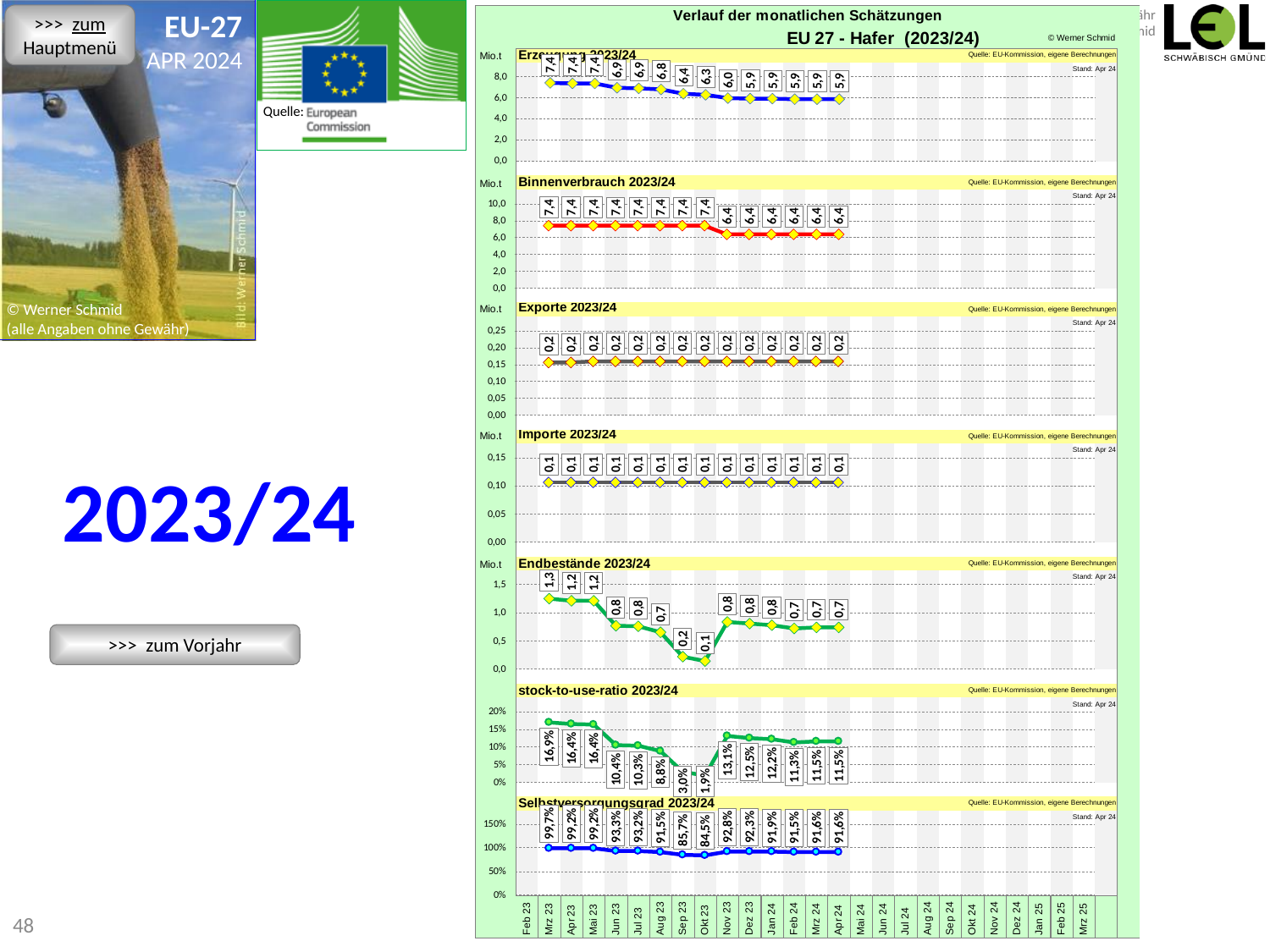
In the 'Selbstversorgungsgrad 2023/24' chart, is the value for Sep 23 larger or smaller than the value for Nov 23? smaller In the 'Erzeugung 2023/24' chart, do the values rise or fall from Mrz 23 to Apr 24? fall In the 'Selbstversorgungsgrad 2023/24' chart, what is the value for Mrz 23? 99,7% In the 'Binnenverbrauch 2023/24' chart, what is the difference between the value for Okt 23 and the value for Nov 23? 1,0 In the 'stock-to-use-ratio 2023/24' chart, what is the value for Okt 23? 1,9% In the 'Binnenverbrauch 2023/24' chart, what is the value for Nov 23? 6,4 In the 'Endbestände 2023/24' chart, which month has the lowest value? Okt 23 In the 'Erzeugung 2023/24' chart, what is the value for Apr 24? 5,9 In the 'Endbestände 2023/24' chart, which month has the highest value? Mrz 23 In the 'Importe 2023/24' chart, what is the value for Apr 24? 0,1 In the 'Erzeugung 2023/24' chart, what is the value for Mrz 23? 7,4 In the 'Exporte 2023/24' chart, what is the value for Jan 24? 0,2